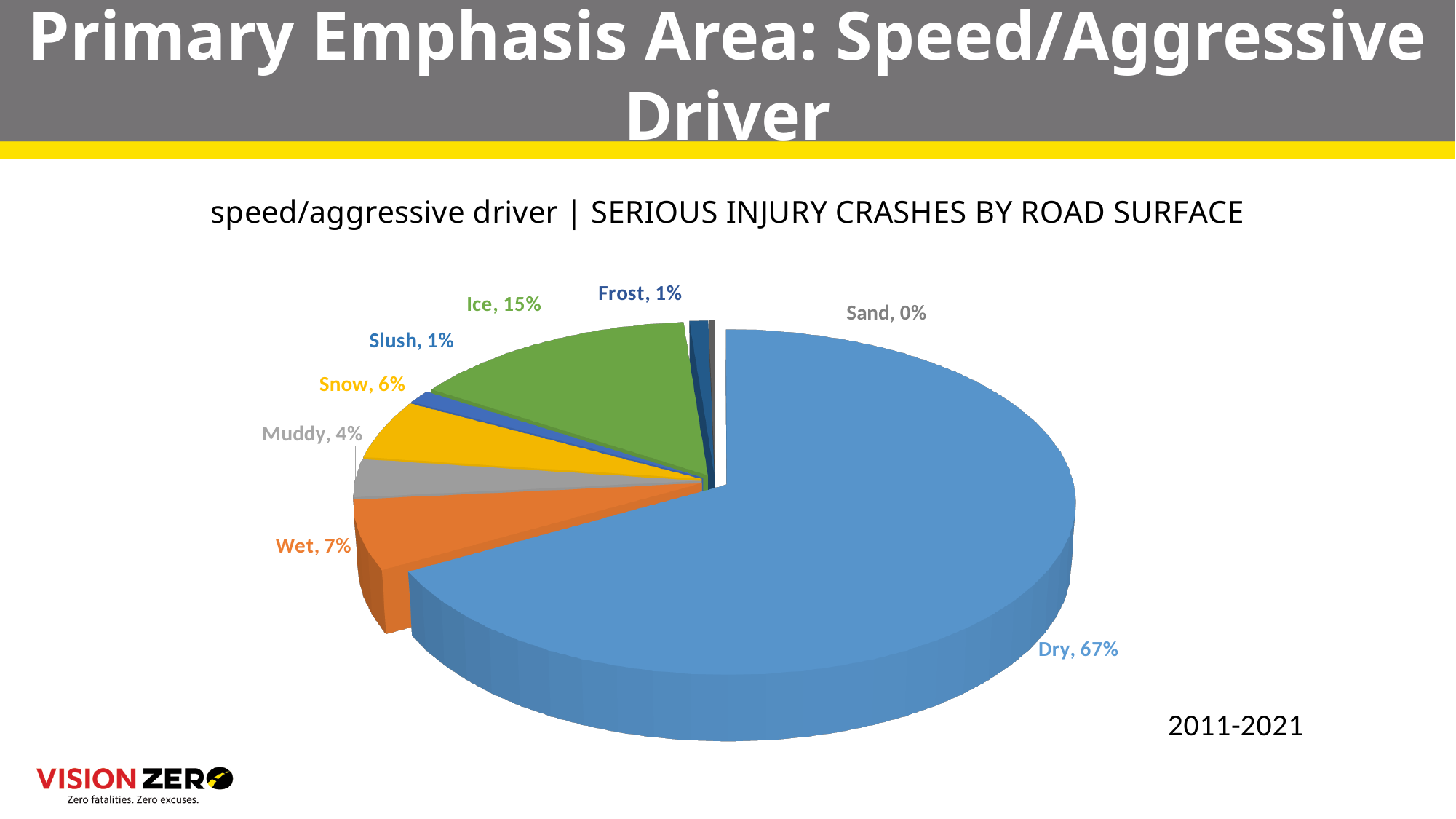
Which road surface category has the smallest share of serious injury crashes? Sand What percentage is shown for Snow? 6% What kind of chart is shown on the slide? Pie chart Which road surface category has the largest share of serious injury crashes? Dry What share of serious injury crashes occurred on a dry road surface? 67% What is the value shown for the Wet slice? 7% How many road surface categories are shown in the pie chart? 8 What percentage of serious injury crashes occurred on ice? 15% Which slice is larger, Wet or Snow? Wet What percentage is shown for Muddy? 4% What time period does the chart cover? 2011-2021 What is the difference in percentage points between the Dry and Ice slices? 52